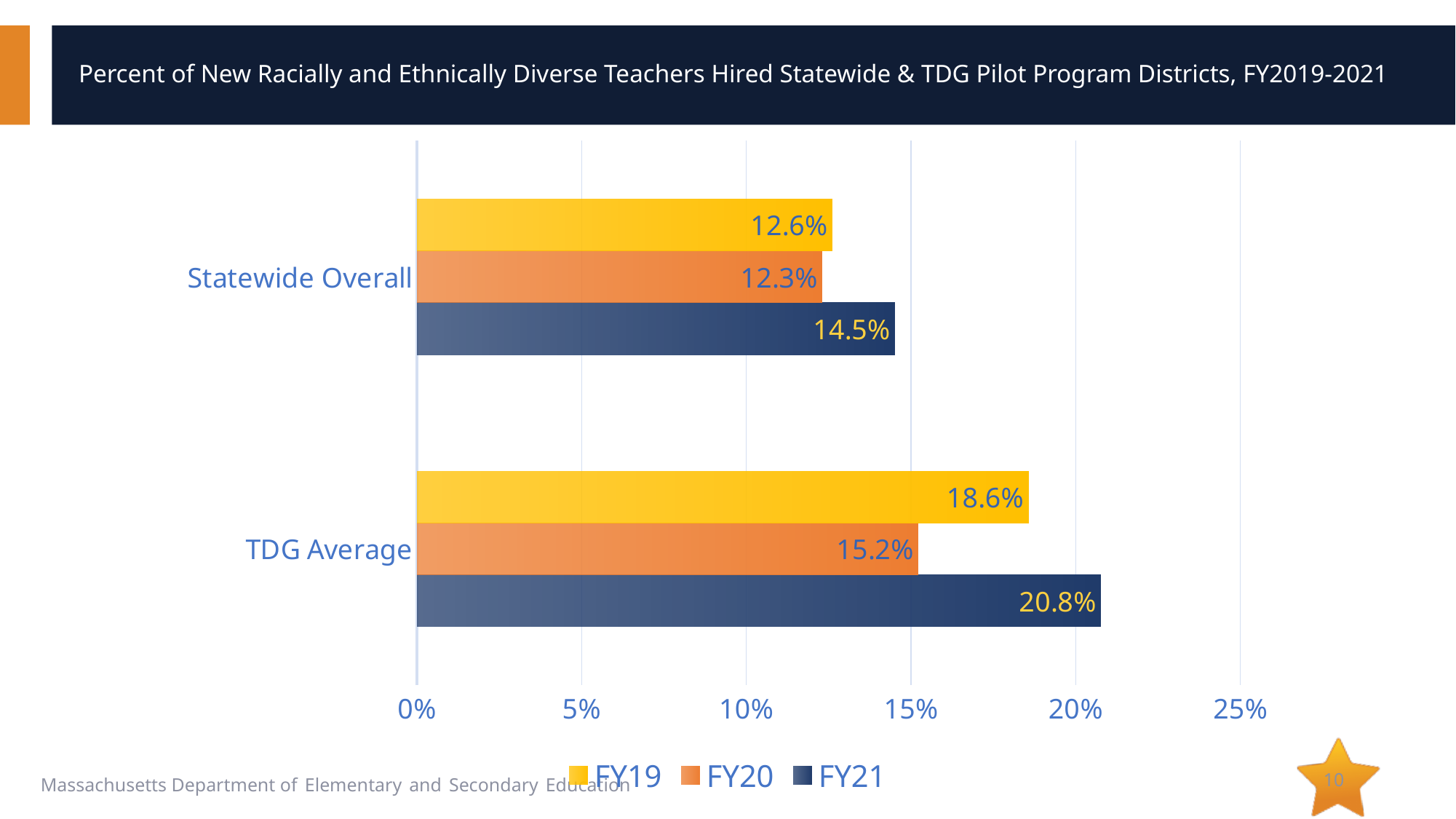
Is the FY21 value for TDG Average greater or less than 20%? greater What is the FY20 value for TDG Average? 15.2% What is the difference between the TDG Average and Statewide Overall values for FY20? 2.9% What is the difference between the FY21 and FY19 values for TDG Average? 2.2% Which is larger, the FY19 value for TDG Average or the FY21 value for Statewide Overall? FY19 value for TDG Average Which category has the highest FY21 value? TDG Average How many categories are shown on the chart? 2 Which fiscal year has the lowest value for Statewide Overall? FY20 What is the FY19 value for Statewide Overall? 12.6% What kind of chart is shown on the slide? Bar chart How many series does the legend list? 3 What is the FY21 value for TDG Average? 20.8%